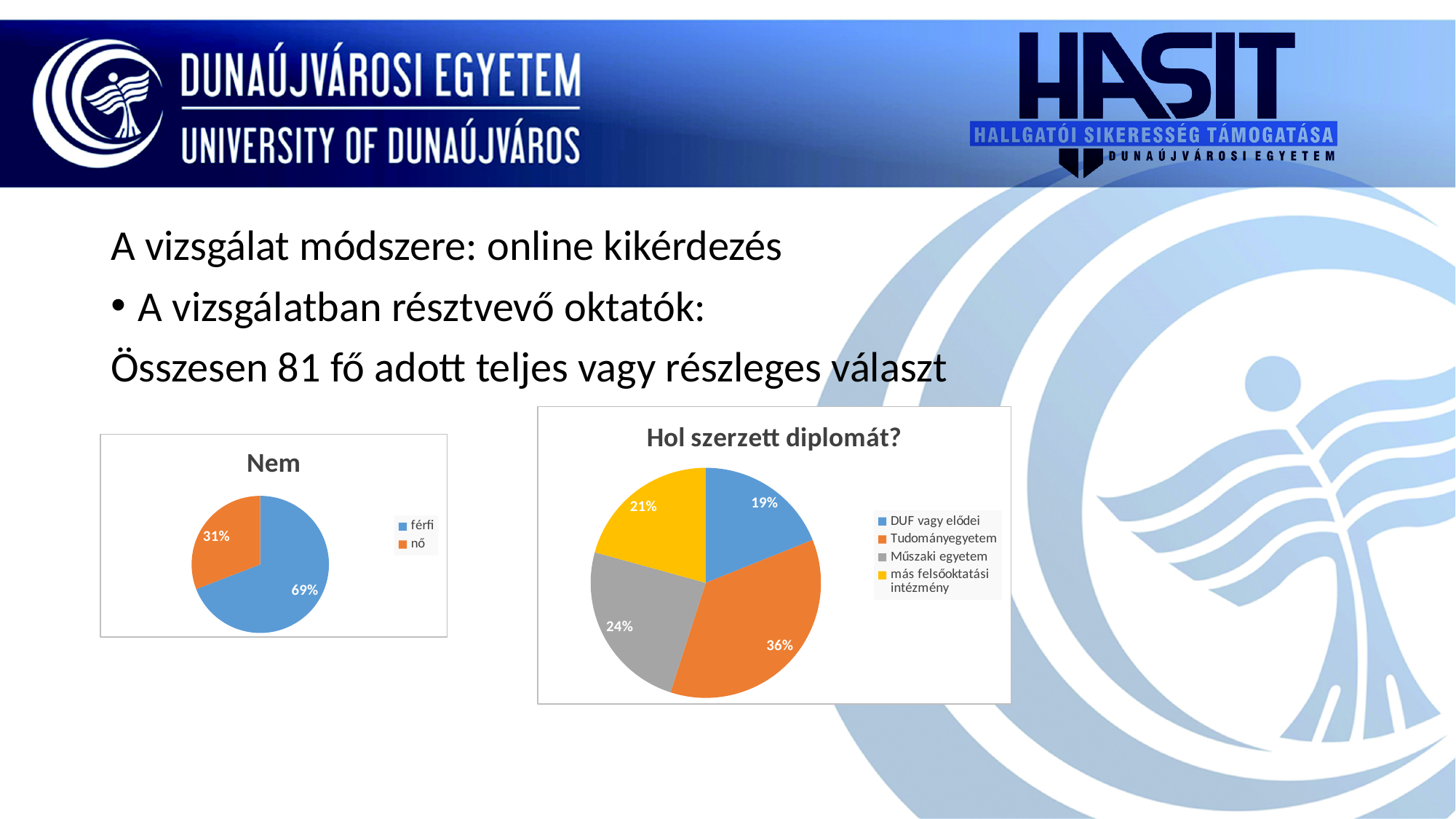
In the "Hol szerzett diplomát?" chart, which category has the smallest share? DUF vagy elődei How many categories does the legend of the "Hol szerzett diplomát?" chart list? 4 In the "Nem" chart, what share is labelled for nő? 31% How many categories does the legend of the "Nem" chart list? 2 In the "Nem" chart, what is the difference between the férfi and nő shares? 38% In the "Hol szerzett diplomát?" chart, what share is labelled for DUF vagy elődei? 19% In the "Nem" chart, what share is labelled for férfi? 69% In the "Hol szerzett diplomát?" chart, what is the difference between the Tudományegyetem and Műszaki egyetem shares? 12% What kind of chart is the "Nem" chart? pie chart In the "Hol szerzett diplomát?" chart, what share is labelled for Tudományegyetem? 36% In the "Hol szerzett diplomát?" chart, which category has the largest share? Tudományegyetem In the "Hol szerzett diplomát?" chart, which is larger: Műszaki egyetem or más felsőoktatási intézmény? Műszaki egyetem